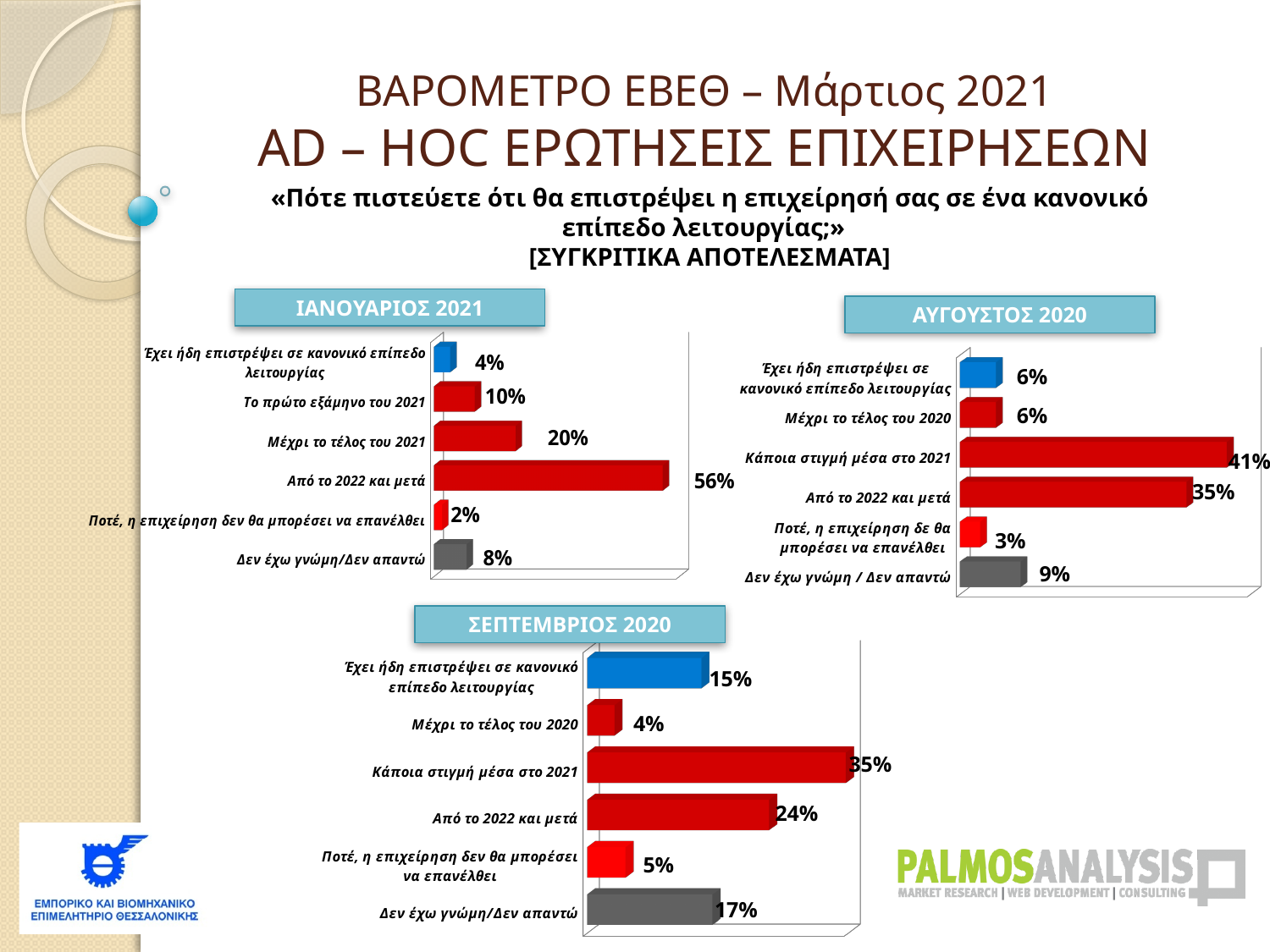
In the ΙΑΝΟΥΑΡΙΟΣ 2021 chart, what is the value for "Από το 2022 και μετά"? 56% In the ΣΕΠΤΕΜΒΡΙΟΣ 2020 chart, which is larger: "Έχει ήδη επιστρέψει σε κανονικό επίπεδο λειτουργίας" or "Από το 2022 και μετά"? Από το 2022 και μετά In the ΑΥΓΟΥΣΤΟΣ 2020 chart, what is the value for "Ποτέ, η επιχείρηση δε θα μπορέσει να επανέλθει"? 3% How many categories are shown in the ΑΥΓΟΥΣΤΟΣ 2020 chart? 6 In the ΙΑΝΟΥΑΡΙΟΣ 2021 chart, which category has the lowest value? Ποτέ, η επιχείρηση δεν θα μπορέσει να επανέλθει In the ΑΥΓΟΥΣΤΟΣ 2020 chart, what is the difference between "Κάποια στιγμή μέσα στο 2021" and "Από το 2022 και μετά"? 6% In the ΑΥΓΟΥΣΤΟΣ 2020 chart, what is the value for "Κάποια στιγμή μέσα στο 2021"? 41% In the ΙΑΝΟΥΑΡΙΟΣ 2021 chart, what is the difference between "Μέχρι το τέλος του 2021" and "Το πρώτο εξάμηνο του 2021"? 10% In the ΣΕΠΤΕΜΒΡΙΟΣ 2020 chart, what is the value for "Δεν έχω γνώμη/Δεν απαντώ"? 17% In the ΣΕΠΤΕΜΒΡΙΟΣ 2020 chart, which category has the highest value? Κάποια στιγμή μέσα στο 2021 What kind of chart is the ΙΑΝΟΥΑΡΙΟΣ 2021 chart? Bar chart How many charts are shown on the slide? 3